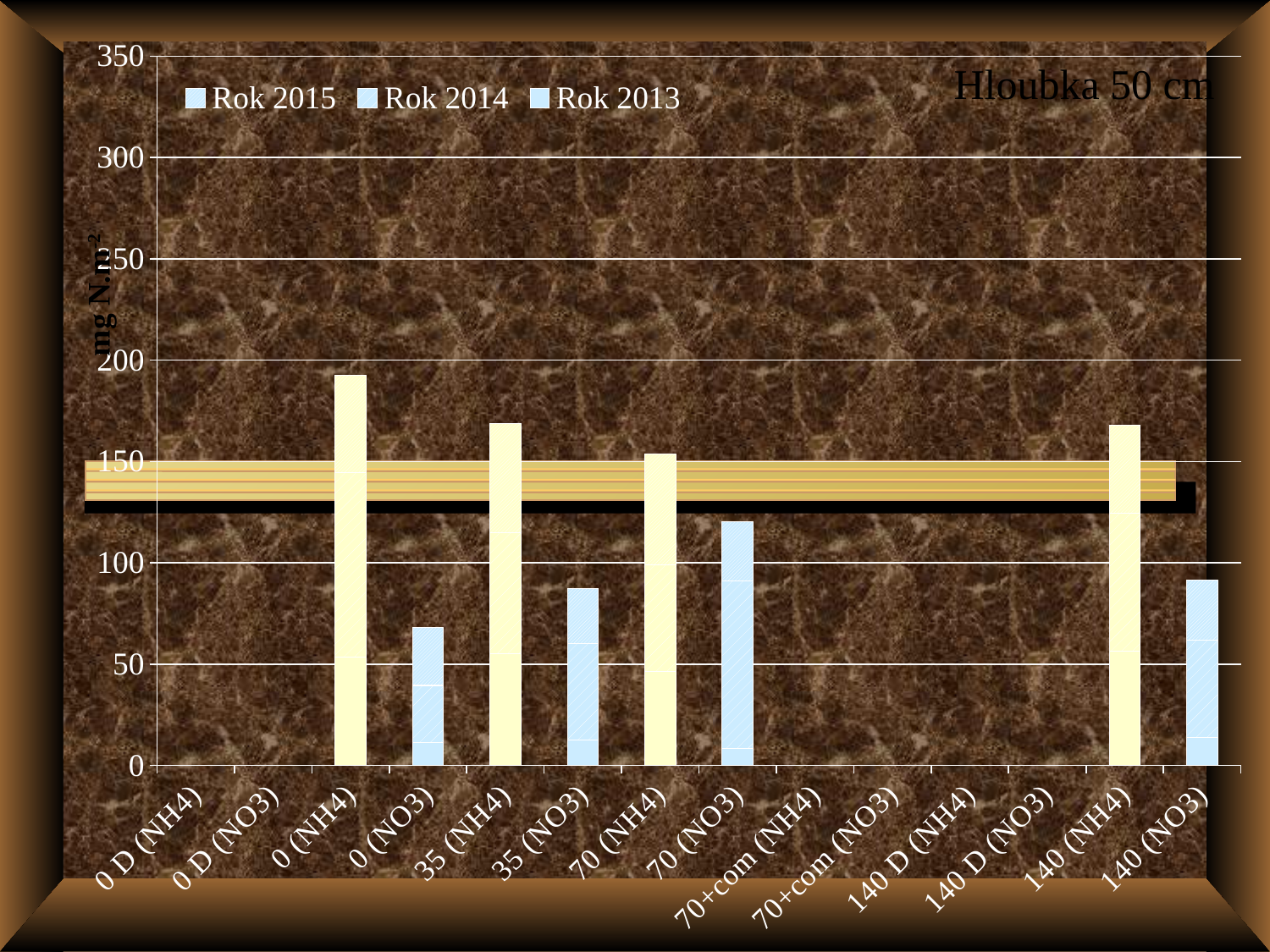
How many series does the legend list? 3 Which is larger, the value for 70 (NO3) or the value for 0 (NO3)? 70 (NO3) Is the value for 0 (NH4) greater or less than 150? greater What is the title shown in the top right of the chart? Hloubka 50 cm Is the value for 70 (NO3) greater or less than 100? greater Which category has the tallest bar? 0 (NH4) Which is larger, the value for 0 (NH4) or the value for 35 (NH4)? 0 (NH4) Is the value for 0 (NO3) greater or less than 100? less How many categories are shown on the x axis? 14 What kind of chart is shown on the slide? bar chart